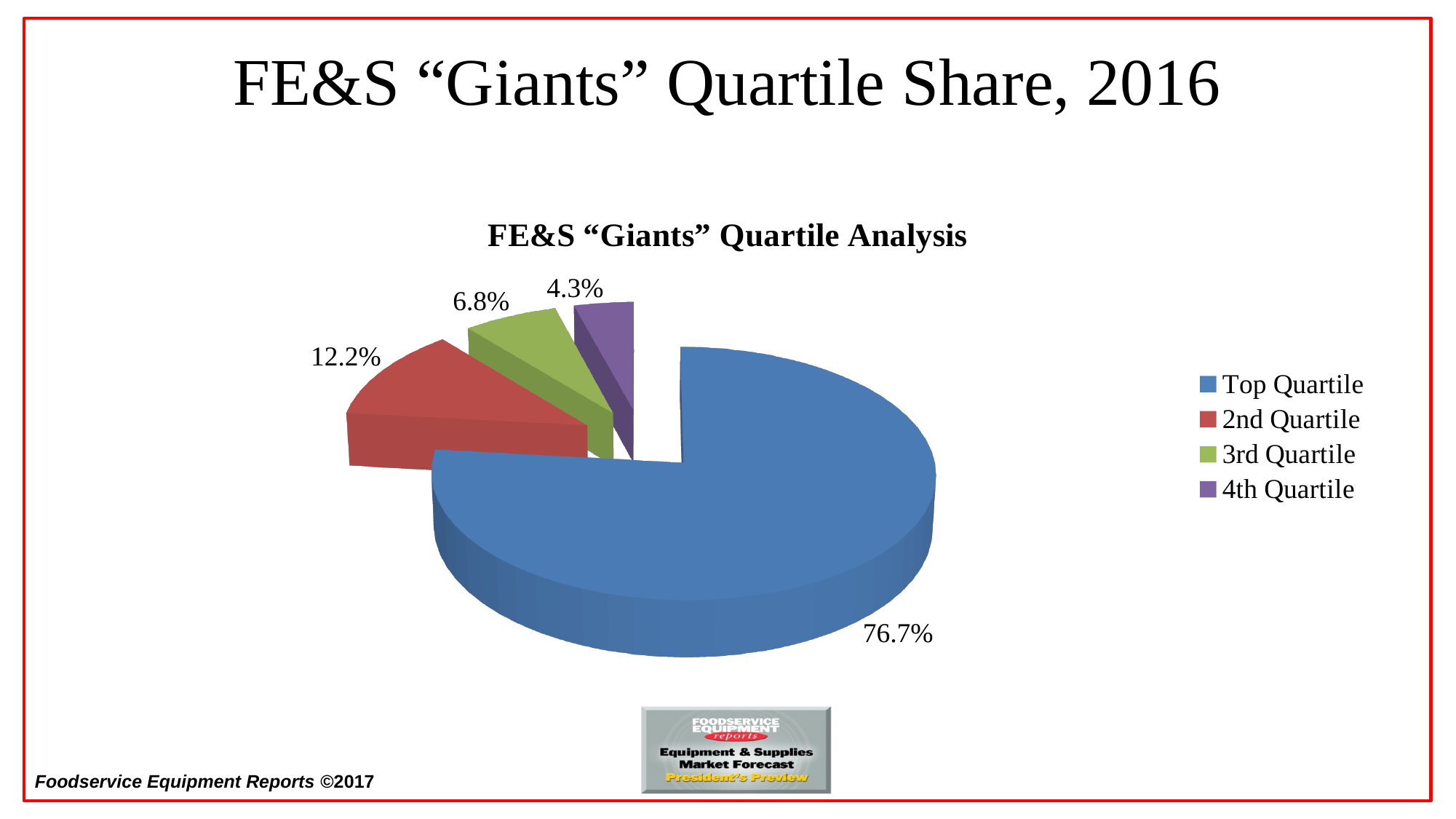
What is the value shown for the 4th Quartile? 4.3% How many slices does the pie chart have? 4 Which quartile has the largest share of the pie? Top Quartile What is the value shown for the 2nd Quartile? 12.2% What is the difference between the Top Quartile share and the 2nd Quartile share? 64.5% What kind of chart is shown on the slide? Pie chart What share of the pie does the Top Quartile hold? 76.7% Which quartile has the smallest share of the pie? 4th Quartile What is the title of the chart? FE&S “Giants” Quartile Analysis What is the value shown for the 3rd Quartile? 6.8% What is the difference between the 3rd Quartile share and the 4th Quartile share? 2.5% Which is larger, the 2nd Quartile share or the 3rd Quartile share? 2nd Quartile